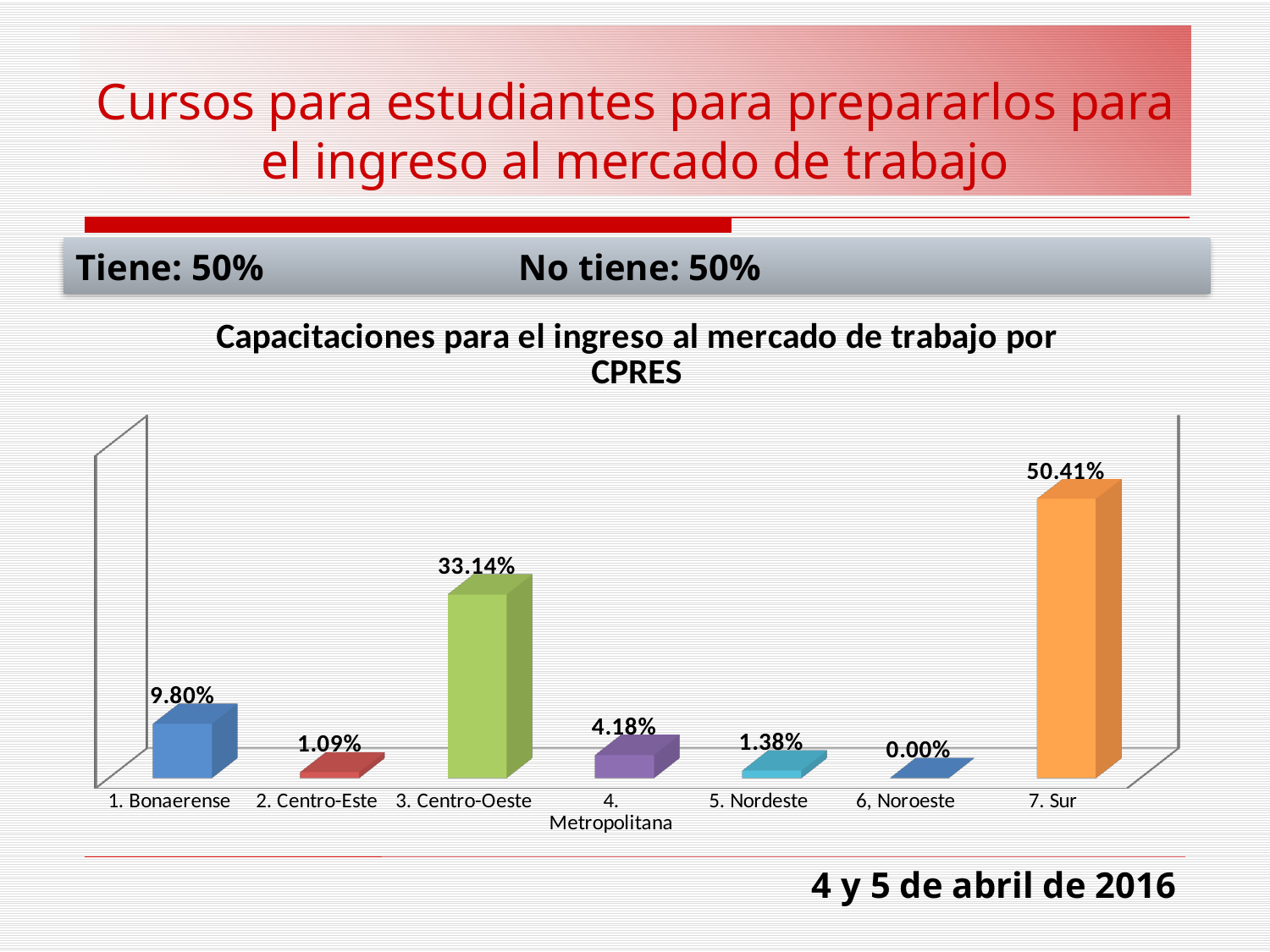
What is the title of the chart? Capacitaciones para el ingreso al mercado de trabajo por CPRES What kind of chart is shown on the slide? bar chart Which category has the highest value? 7. Sur What is the value for 1. Bonaerense? 9.80% What is the value for 3. Centro-Oeste? 33.14% Which category has the lowest value? 6, Noroeste What is the value for 6, Noroeste? 0.00% What is the value for 4. Metropolitana? 4.18% Which is larger, the value for 5. Nordeste or the value for 2. Centro-Este? 5. Nordeste How many categories are shown on the x axis? 7 What is the difference between the values for 7. Sur and 3. Centro-Oeste? 17.27% What is the value for 7. Sur? 50.41%